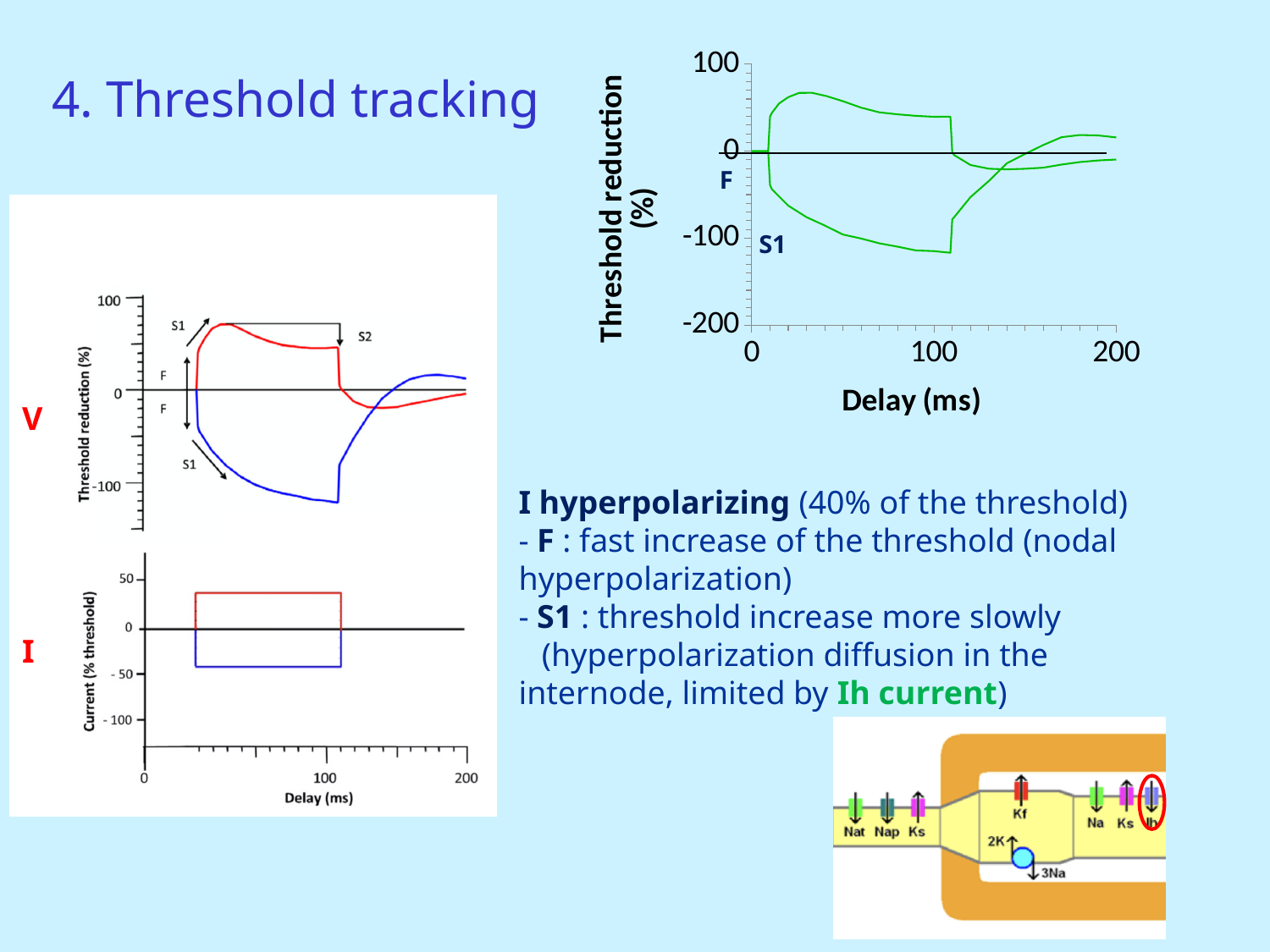
In the top-right chart, does the lower green curve rise or fall between delays of about 20 ms and 100 ms? fall In the top-right chart, what is the label of the x axis? Delay (ms) In the top-right chart, what is the label of the y axis? Threshold reduction (%) In the top-right chart, is the value of the upper green curve at a delay of 100 ms greater or less than 0? greater In the bottom-left chart labelled I (Current, % threshold), is the value of the red trace between 30 ms and 110 ms greater or less than 0? greater What kind of chart is the top-right chart with the green curves? line chart In the top-right chart, how many green curves are plotted? 2 In the top-left chart labelled V, is the minimum of the blue curve greater or less than -100? less In the top-right chart, which of the two green curves has the larger value at a delay of 50 ms, the upper one or the lower one? the upper one In the top-right chart, does the lower green curve rise or fall between delays of about 120 ms and 200 ms? rise